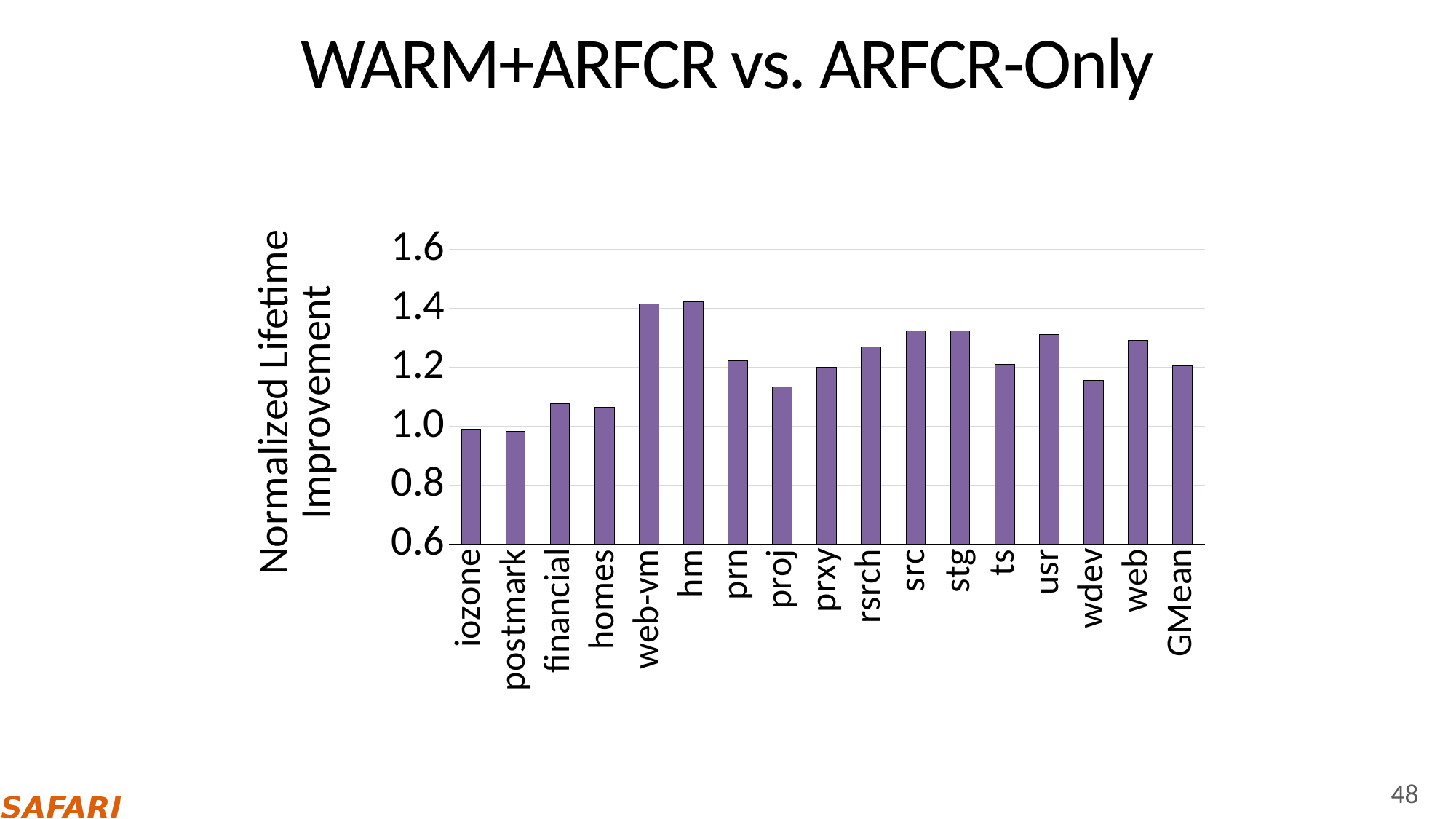
Which has the larger value, financial or web-vm? web-vm What is the label of the y axis? Normalized Lifetime Improvement Which has the larger value, hm or proj? hm Which has the larger value, src or homes? src Is the value for iozone greater or less than 1.2? less What is the title of the chart? WARM+ARFCR vs. ARFCR-Only Is the value for proj greater or less than 1.2? less How many categories are plotted along the x axis? 17 Is the value for src greater or less than 1.2? greater What kind of chart is shown on the slide? bar chart